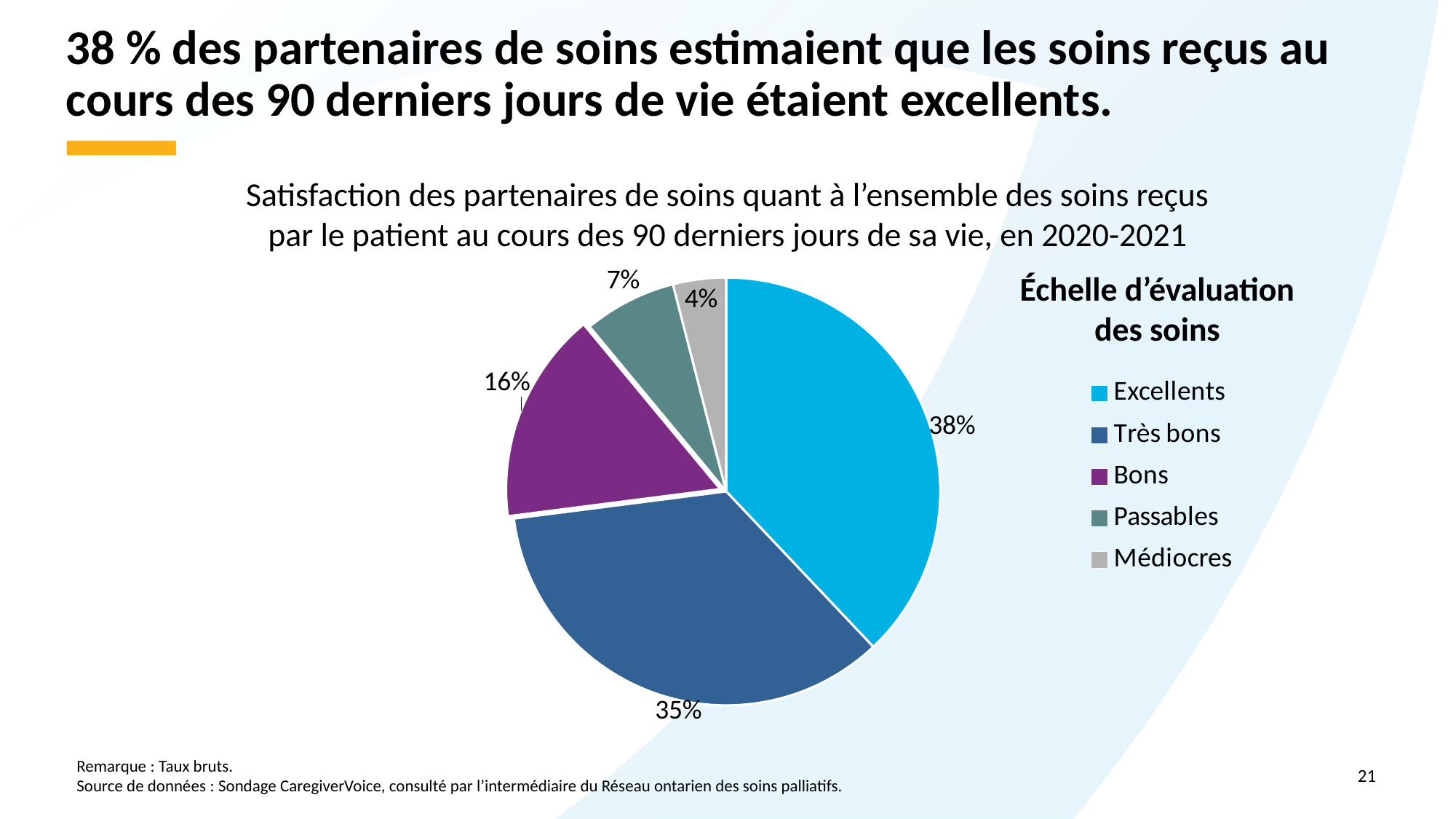
What is the value for Très bons? 35% What kind of chart is shown? Pie chart Which category has the largest slice? Excellents What is the difference between the Excellents and Très bons slices? 3% What share of the pie is labelled Excellents? 38% What is the title of the legend? Échelle d’évaluation des soins Which category has the smallest slice? Médiocres Which is larger, Bons or Passables? Bons How many categories does the legend list? 5 What is the value for Passables? 7% What is the value for Bons? 16% What is the value for Médiocres? 4%